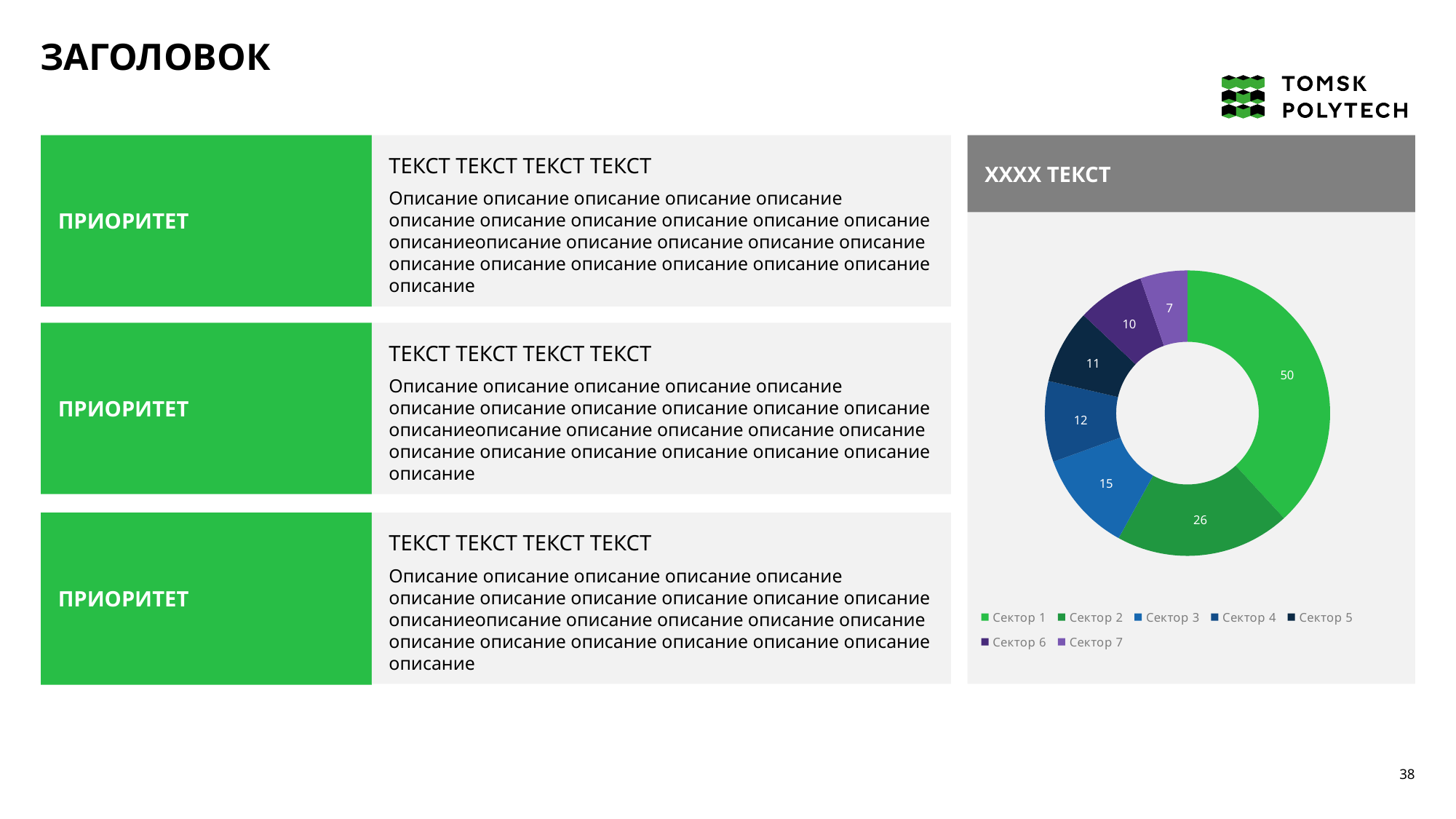
Which is larger, the value for Сектор 4 or the value for Сектор 5? Сектор 4 What is the value for Сектор 7 in the doughnut chart? 7 What is the difference between the values of Сектор 1 and Сектор 2? 24 What is the total of all sector values in the doughnut chart? 131 How many sectors does the doughnut chart contain? 7 Which sector has the smallest value in the doughnut chart? Сектор 7 What is the title shown above the doughnut chart? XXXX ТЕКСТ What is the value for Сектор 1 in the doughnut chart? 50 What is the value for Сектор 3 in the doughnut chart? 15 Which sector has the largest value in the doughnut chart? Сектор 1 What type of chart is shown on the slide? Doughnut chart What is the difference between the values of Сектор 3 and Сектор 6? 5